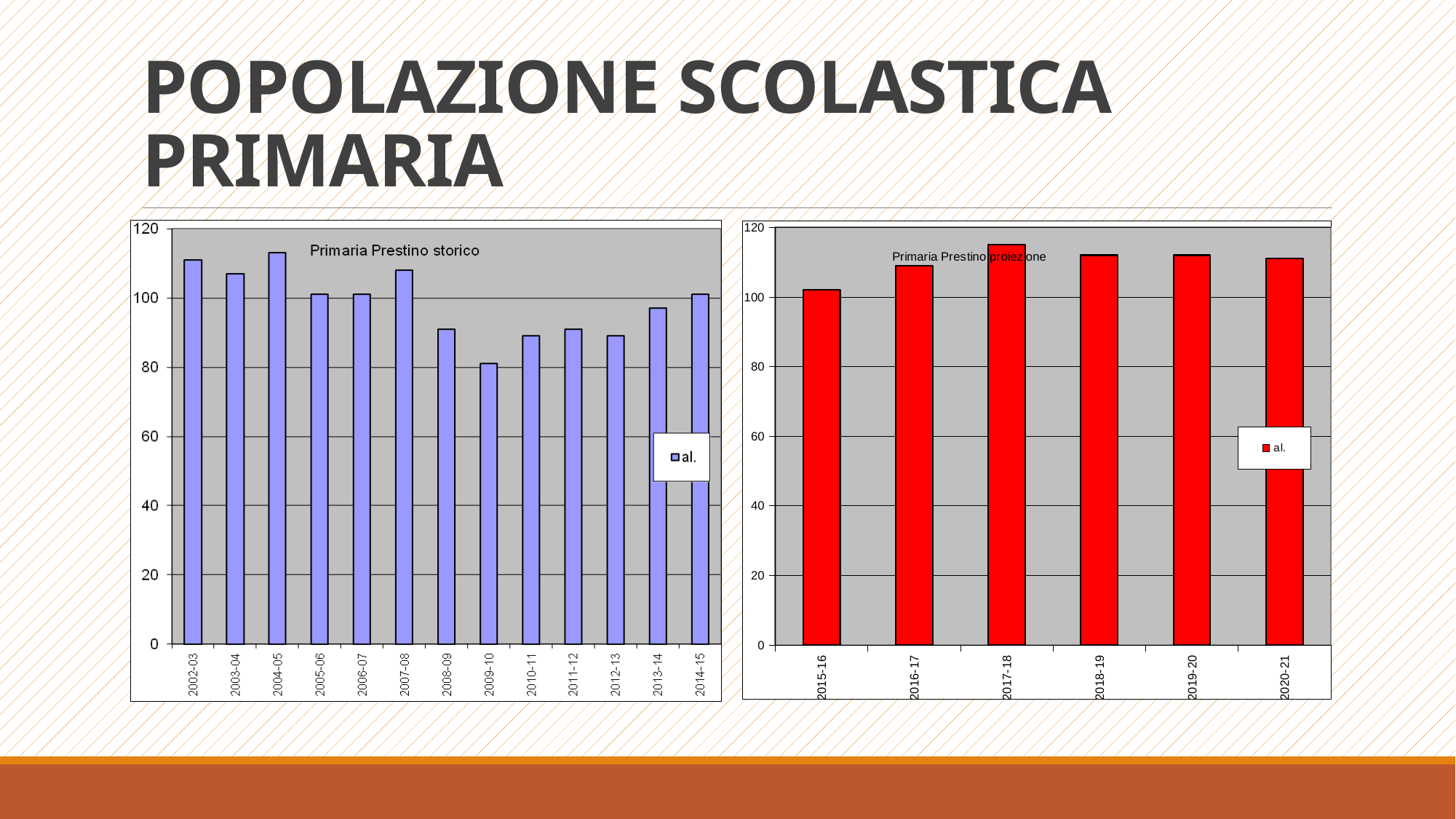
On the 'Primaria Prestino storico' chart, which is larger, the value for 2002-03 or the value for 2009-10? 2002-03 On the 'Primaria Prestino proiezione' chart, which school year has the lowest value? 2015-16 On the 'Primaria Prestino proiezione' chart, is the value for 2017-18 greater or less than 100? greater What kind of chart is the 'Primaria Prestino storico' chart on the left? bar chart How many series does the legend of the 'Primaria Prestino proiezione' chart list? 1 On the 'Primaria Prestino storico' chart, which school year has the lowest value? 2009-10 On the 'Primaria Prestino storico' chart, which school year has the highest value? 2004-05 What colour are the bars on the 'Primaria Prestino proiezione' chart on the right? red On the 'Primaria Prestino storico' chart, is the value for 2009-10 greater or less than 100? less How many school years are shown on the 'Primaria Prestino storico' chart on the left? 13 On the 'Primaria Prestino proiezione' chart, which school year has the highest value? 2017-18 How many school years are shown on the 'Primaria Prestino proiezione' chart on the right? 6